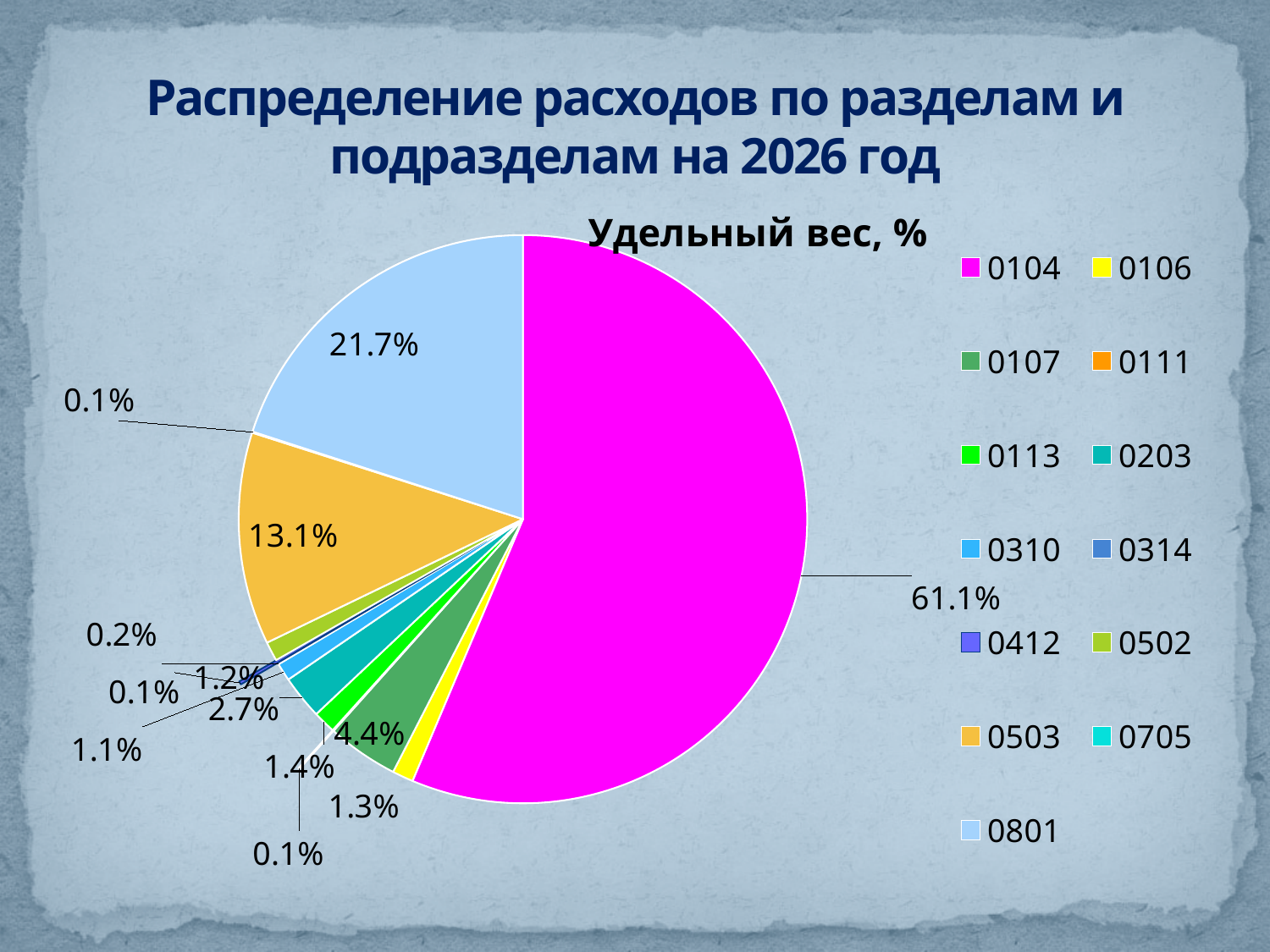
Which is larger, the share for 0801 or the share for 0503? 0801 What is the difference between the shares of 0503 and 0107? 8.7% What share of the pie does category 0801 have? 21.7% How many categories does the legend list? 13 What share of the pie does category 0203 have? 2.7% What share of the pie does category 0503 have? 13.1% Which category has the largest share of the pie? 0104 What kind of chart is shown on the slide? pie chart What is the title of the chart? Удельный вес, % What share of the pie does category 0104 have? 61.1% What share of the pie does category 0107 have? 4.4% What is the difference between the shares of 0104 and 0801? 39.4%